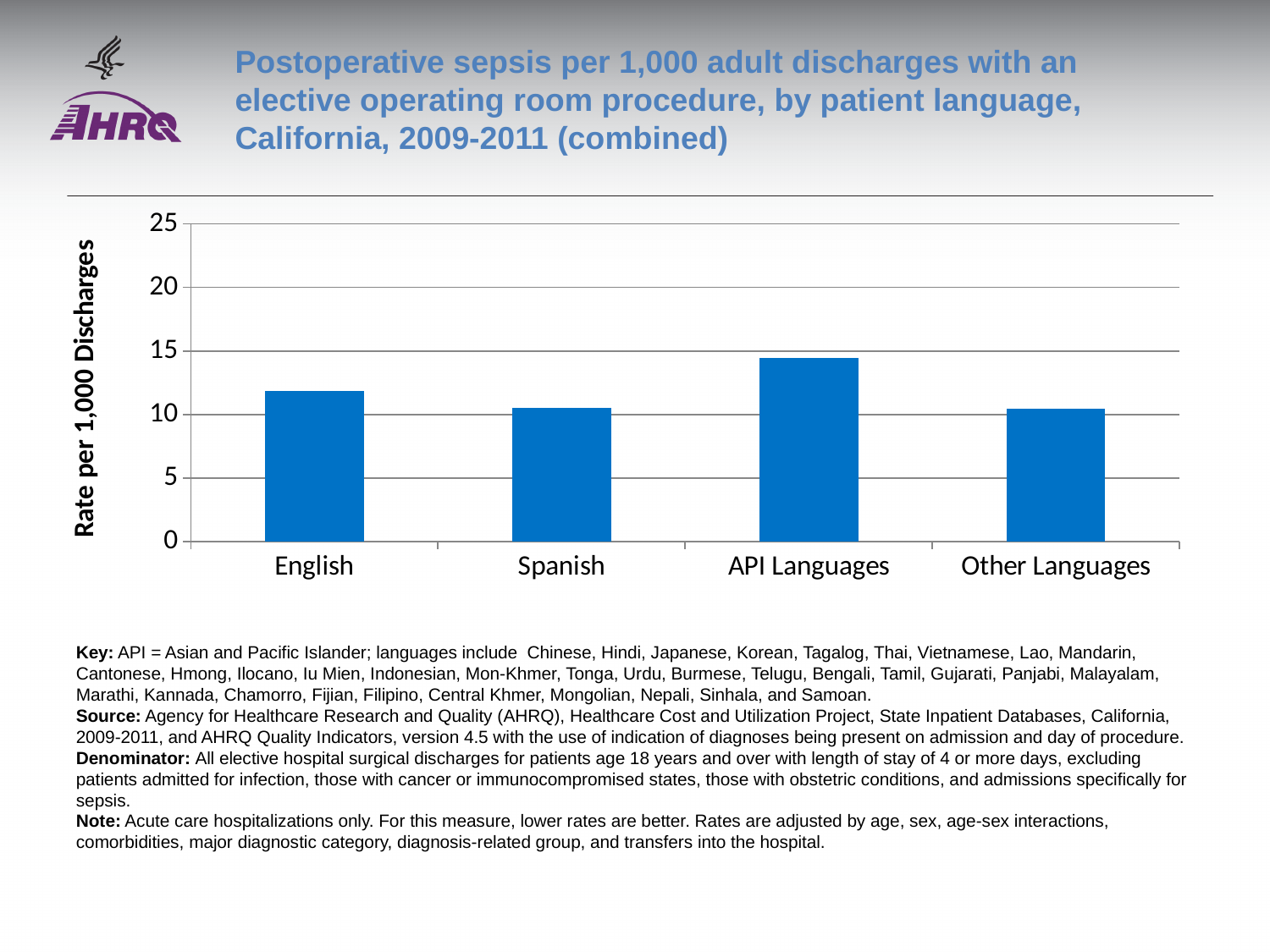
How many patient language categories are shown on the x axis? 4 Is the rate for API Languages greater or less than 10 per 1,000 discharges? greater Which patient language category has the highest postoperative sepsis rate? API Languages Is the rate for Spanish greater or less than 15 per 1,000 discharges? less Which is larger, the rate for API Languages or the rate for Spanish? API Languages Is the rate for English greater or less than 10 per 1,000 discharges? greater Which is larger, the rate for English or the rate for Other Languages? English What kind of chart is shown on the slide? bar chart What is the label on the vertical axis of the chart? Rate per 1,000 Discharges